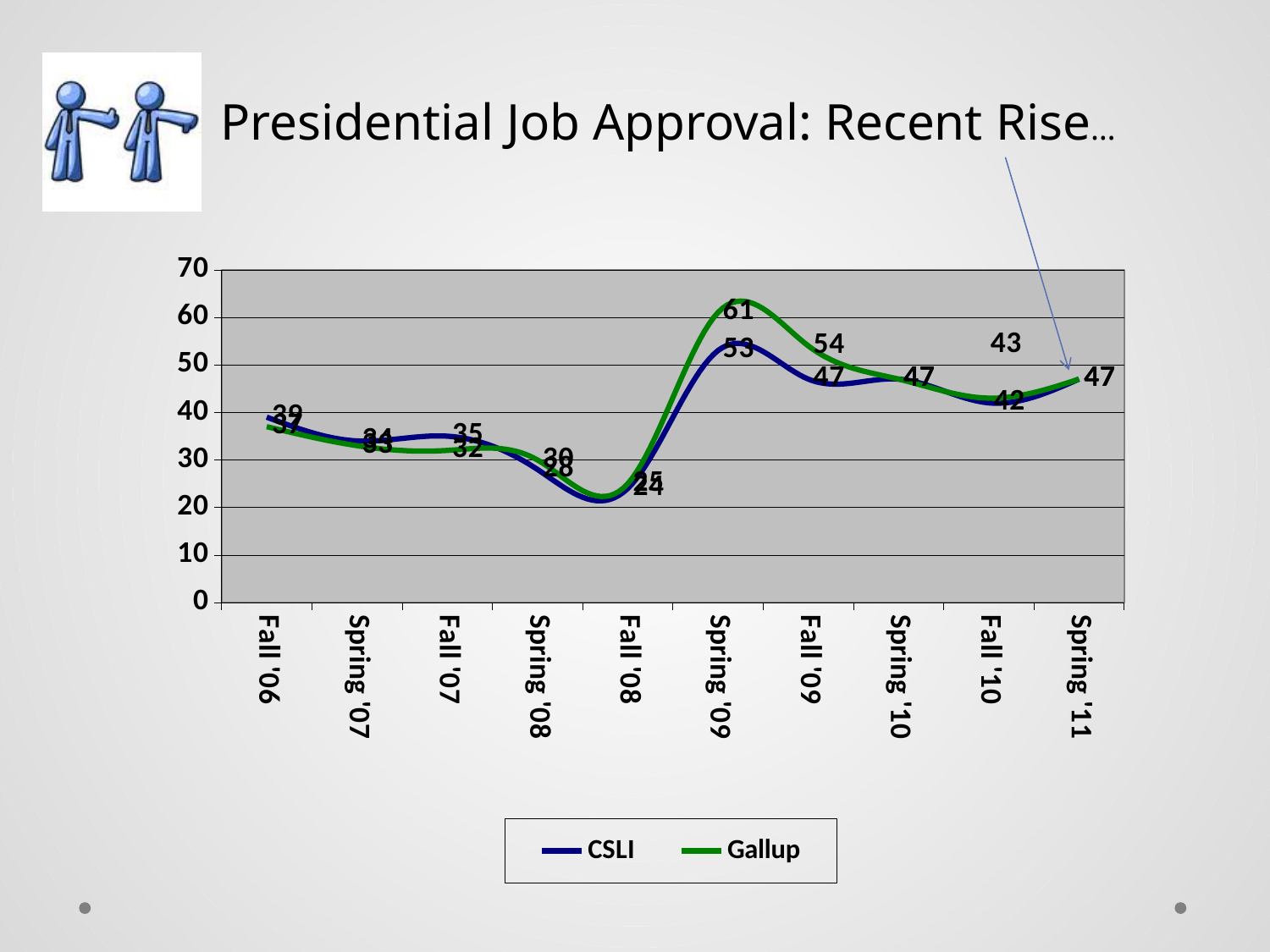
What is the Gallup value for Spring '09? 61 What is the difference between the Gallup and CSLI values in Spring '09? 8 What is the Gallup value for Fall '09? 54 What is the CSLI value for Spring '09? 53 What is the Gallup value for Fall '10? 43 At which time point do both series reach their lowest value? Fall '08 How many time points are shown on the x axis? 10 Is the CSLI value for Fall '08 greater or less than 30? less What kind of chart is shown on the slide? line chart At which time point does the Gallup series reach its highest value? Spring '09 Do the values rise or fall from Fall '06 to Fall '08? fall How many series does the legend list? 2